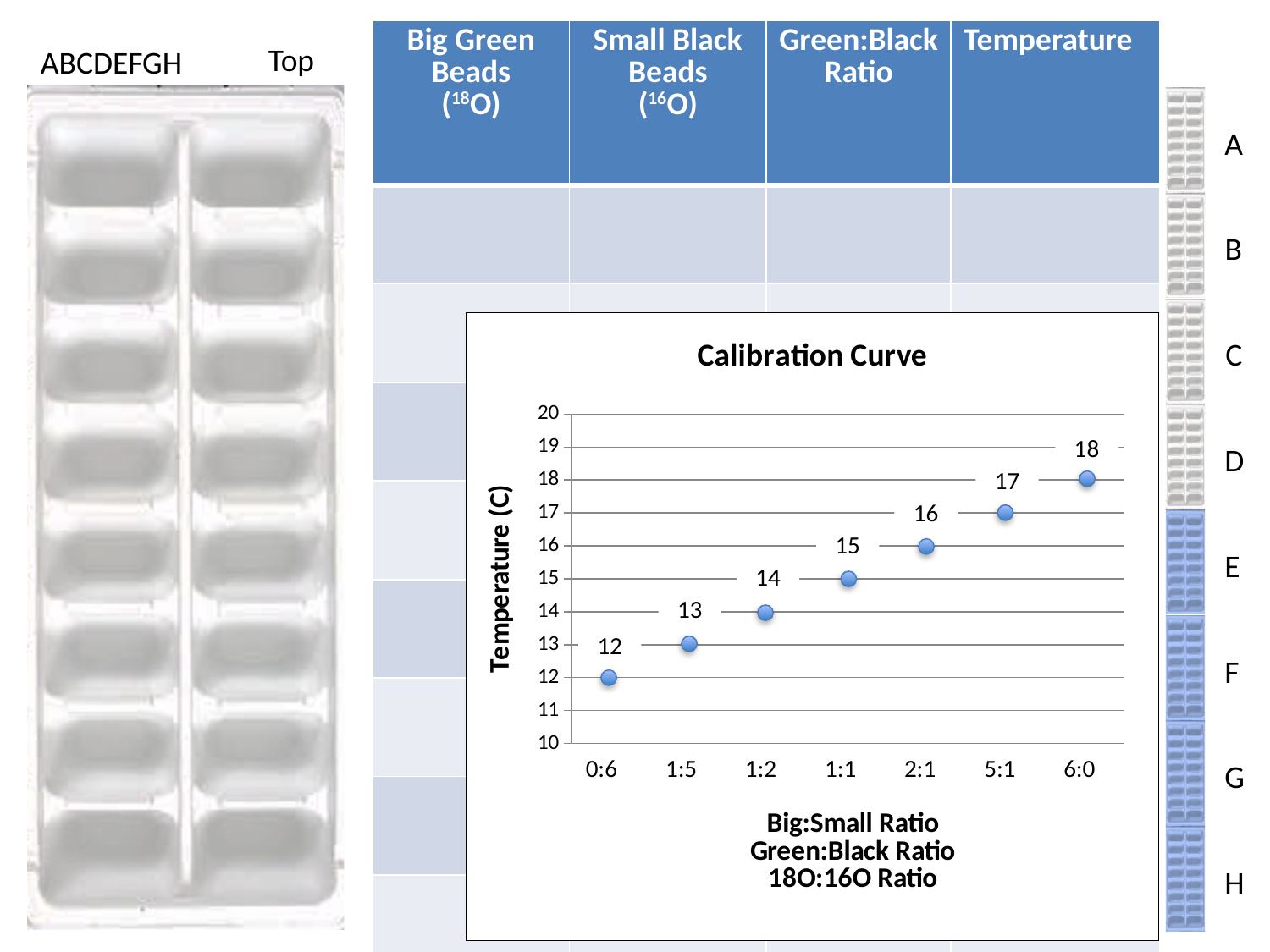
Which ratio has the lowest temperature? 0:6 What is the temperature value for the 0:6 ratio? 12 What is the title of the chart? Calibration Curve What is the difference in temperature between the 6:0 and 0:6 ratios? 6 What is the temperature value for the 5:1 ratio? 17 Which ratio has the highest temperature? 6:0 Do the temperature values rise or fall along the x axis from 0:6 to 6:0? rise What is the temperature value for the 6:0 ratio? 18 What is the temperature value for the 1:1 ratio? 15 How many data points are plotted on the chart? 7 What is the y-axis label of the chart? Temperature (C) Which has a higher temperature, the 1:2 ratio or the 2:1 ratio? 2:1